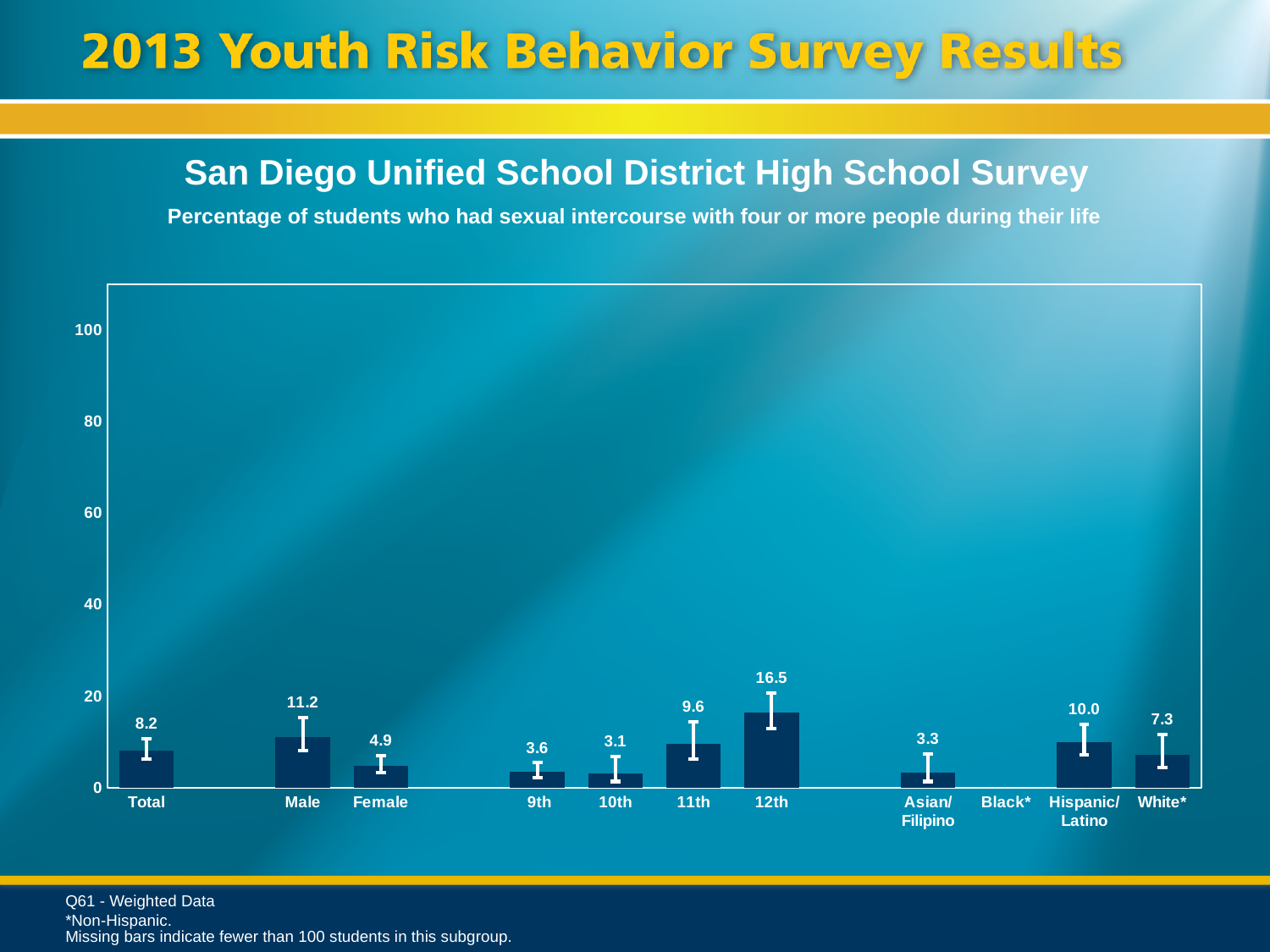
Is the value for 12th grade greater or less than 20? less What is the value for Hispanic/Latino? 10.0 What is the difference between the Male and Female values? 6.3 What kind of chart is shown on the slide? bar chart Which is larger, the value for 11th grade or the value for White*? 11th Which category has the highest value? 12th Which category has no bar shown on the chart? Black* What is the value for Male? 11.2 Which category has the lowest value among those with bars shown? 10th What is the value for 12th grade? 16.5 How many categories have bars plotted on the chart? 10 What is the value for Total? 8.2